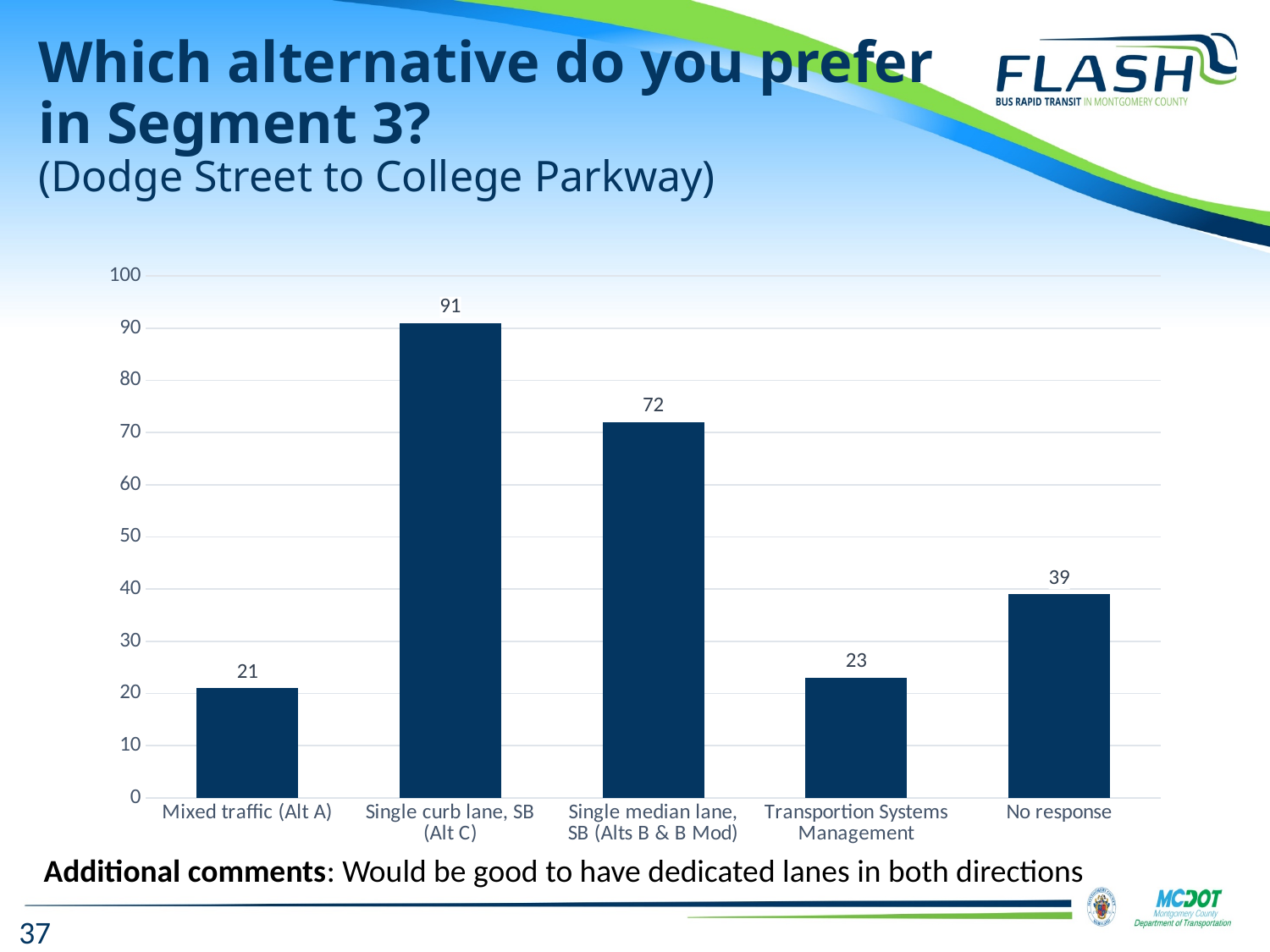
What is the value for Single curb lane, SB (Alt C)? 91 What is the total of the values for Mixed traffic (Alt A) and Transportion Systems Management? 44 What is the value for Mixed traffic (Alt A)? 21 What is the value for No response? 39 What is the difference between the values for Single curb lane, SB (Alt C) and Single median lane, SB (Alts B & B Mod)? 19 How many categories are shown on the x axis? 5 Which category has the lowest value? Mixed traffic (Alt A) Which category has the highest value? Single curb lane, SB (Alt C) Is the value for Single median lane, SB (Alts B & B Mod) greater or less than 70? greater What is the value for Transportion Systems Management? 23 Which is larger, the value for No response or the value for Transportion Systems Management? No response What kind of chart is shown on the slide? bar chart